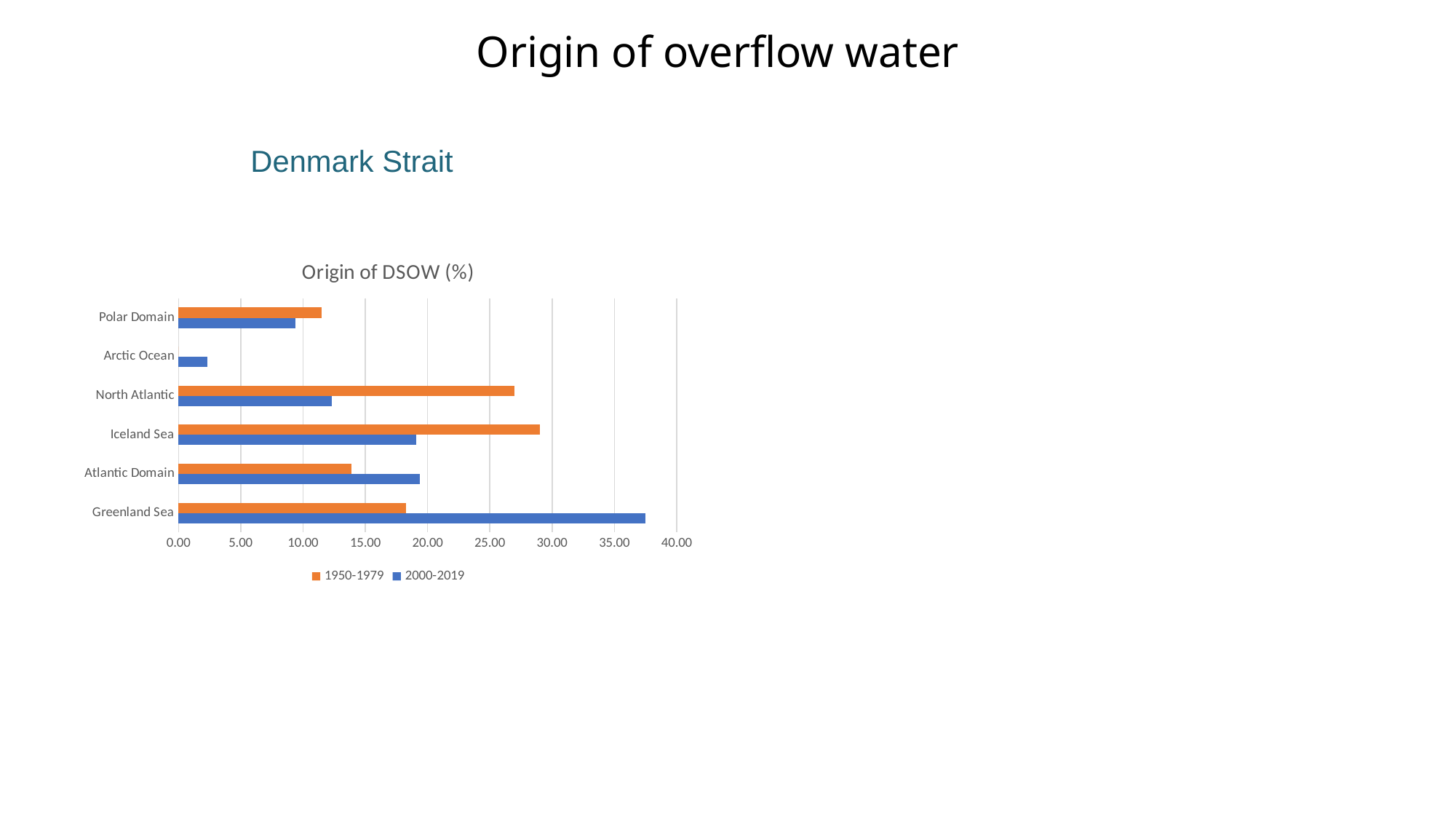
Is the 1950-1979 value for Atlantic Domain greater or less than 15.00? less What is the title of the chart? Origin of DSOW (%) What kind of chart is shown on the slide? bar chart Which category has the highest value for the 2000-2019 series? Greenland Sea Is the 2000-2019 value for Greenland Sea greater or less than 35.00? greater How many series does the chart's legend list? 2 Is the 2000-2019 value for Arctic Ocean greater or less than 5.00? less Which category has the lowest value for the 1950-1979 series? Arctic Ocean How many categories are shown on the chart's vertical axis? 6 For Greenland Sea, which series has the larger value, 1950-1979 or 2000-2019? 2000-2019 For North Atlantic, which series has the larger value, 1950-1979 or 2000-2019? 1950-1979